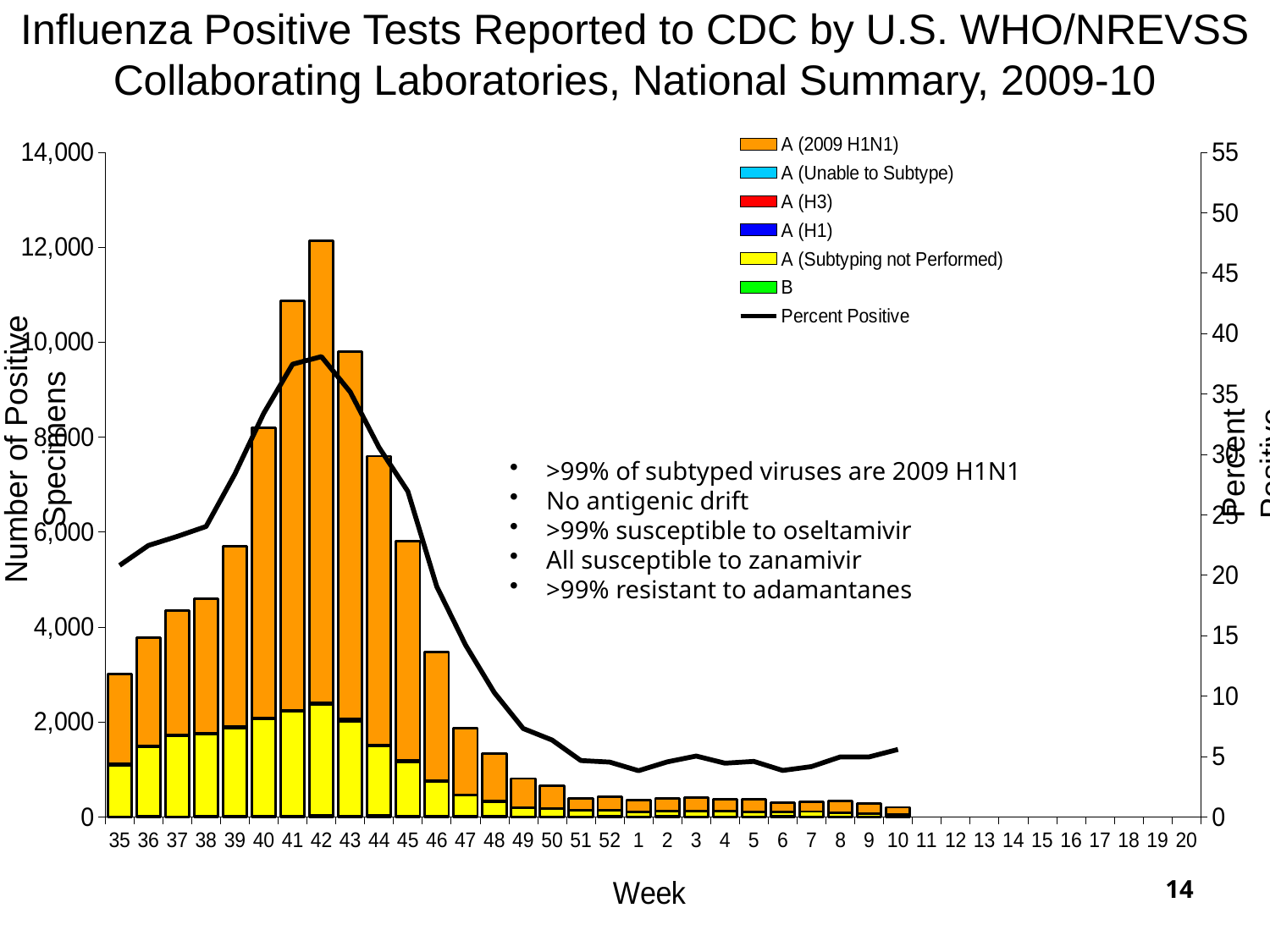
Which week has the tallest bar for number of positive specimens? 42 Is the Percent Positive value at week 42 greater or less than 35? greater Is the total number of positive specimens in week 35 greater or less than 4,000? less Do the bar totals rise or fall from week 42 through week 10? fall What is the title of the x axis? Week What kind of chart is shown on the slide? bar chart with a line Which week has the larger total bar, week 41 or week 43? 41 How many series does the legend list? 7 How many weeks on the x axis have bars plotted? 28 Is the total number of positive specimens in week 41 greater or less than 10,000? greater Among the weeks with bars plotted, which week has the shortest bar? 10